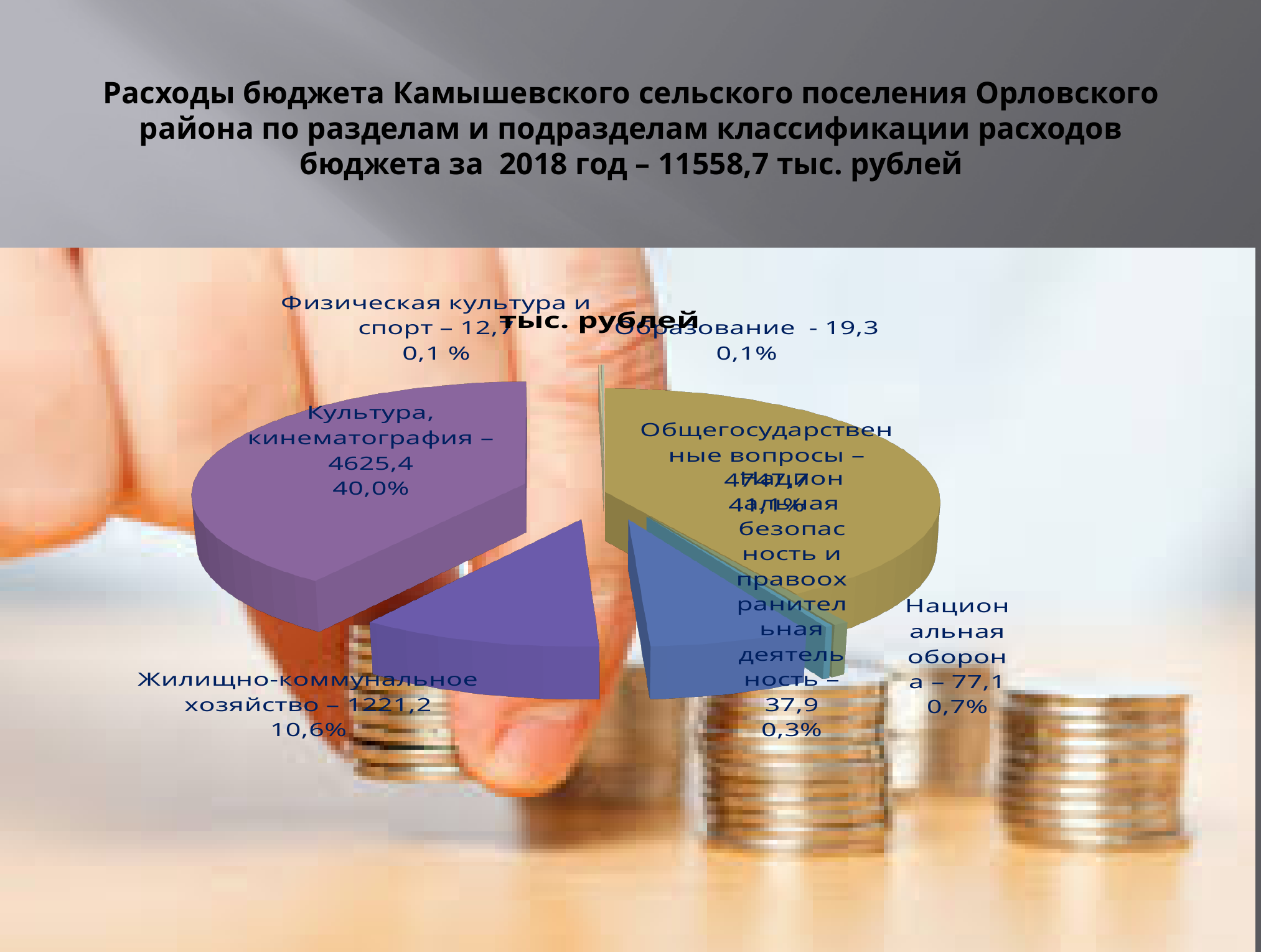
Which is larger: the value for Культура, кинематография or the value for Жилищно-коммунальное хозяйство? Культура, кинематография What is the title printed above the pie chart? тыс. рублей What is the value for Культура, кинематография on the pie chart? 4625,4 Which category has the smallest value on the pie chart? Физическая культура и спорт What is the value for Национальная оборона on the pie chart? 77,1 How many categories are shown on the pie chart? 8 What is the value for Жилищно-коммунальное хозяйство on the pie chart? 1221,2 What kind of chart is shown on the slide? Pie chart What share of the pie does Жилищно-коммунальное хозяйство represent? 10,6% What is the difference between the values for Национальная оборона and Национальная безопасность и правоохранительная деятельность? 39,2 What is the value for Образование on the pie chart? 19,3 What share of the pie does Культура, кинематография represent? 40,0%